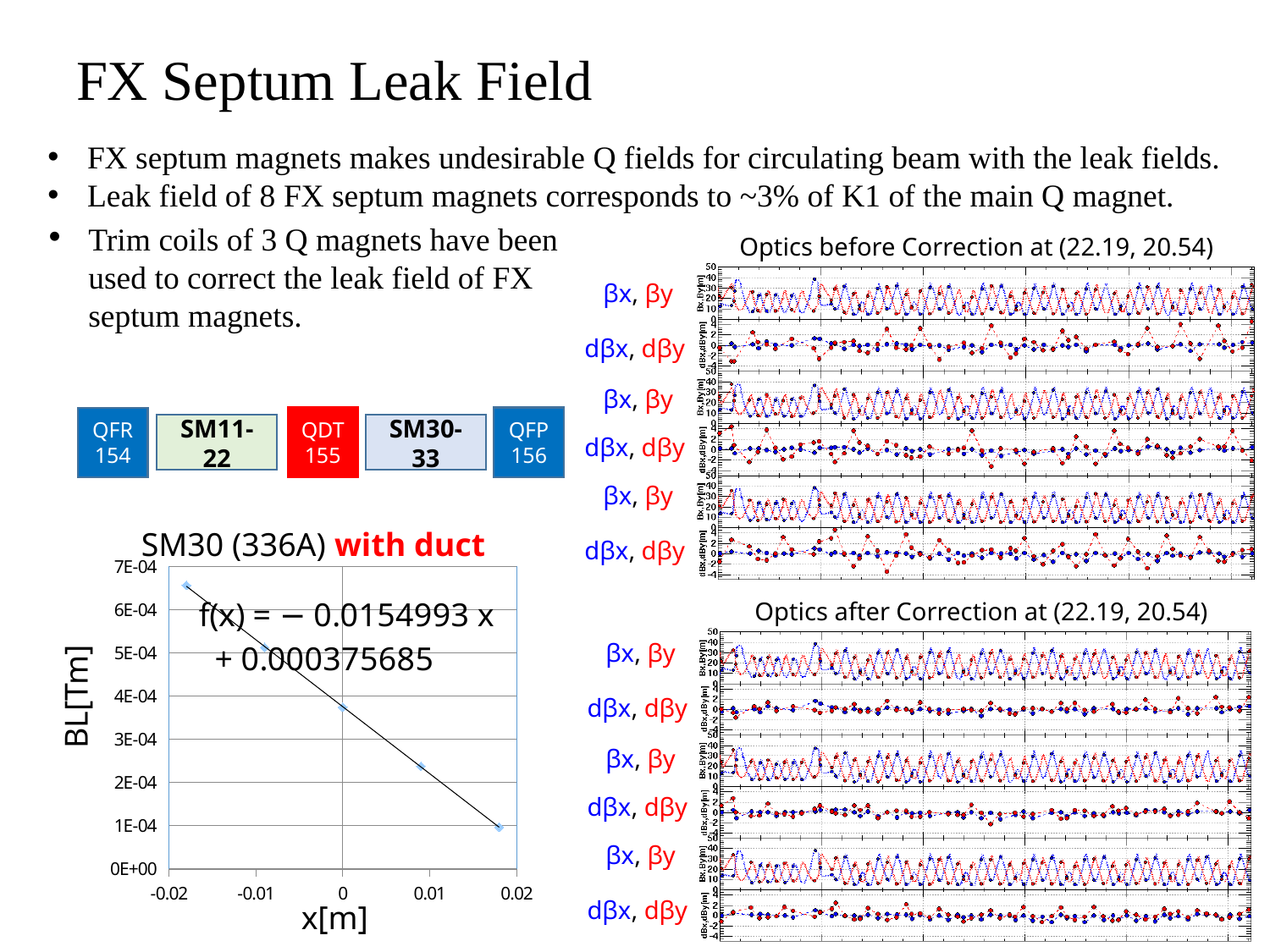
In the 'SM30 (336A) with duct' chart, which point has the lowest BL value: the one with the smallest x or the one with the largest x? the one with the largest x In the 'SM30 (336A) with duct' chart, is the BL value at x = 0 greater or less than 3E-04? greater In the 'SM30 (336A) with duct' chart, does BL rise or fall as x increases? fall In the 'SM30 (336A) with duct' chart, is the BL value of the leftmost point (near x = -0.02) greater or less than 6E-04? greater In the 'SM30 (336A) with duct' chart, which is larger: the BL value at x = 0 or the BL value at x ≈ 0.01? the BL value at x = 0 What is the slope of the fitted line f(x) shown on the 'SM30 (336A) with duct' chart? −0.0154993 In the 'SM30 (336A) with duct' chart, is the BL value of the rightmost point (near x = 0.02) greater or less than 2E-04? less What is the y-axis label of the 'SM30 (336A) with duct' chart? BL[Tm] In the 'SM30 (336A) with duct' chart, which point has the highest BL value: the one with the smallest x or the one with the largest x? the one with the smallest x How many data points are plotted in the 'SM30 (336A) with duct' chart? 5 What kind of chart is the 'SM30 (336A) with duct' chart? scatter chart